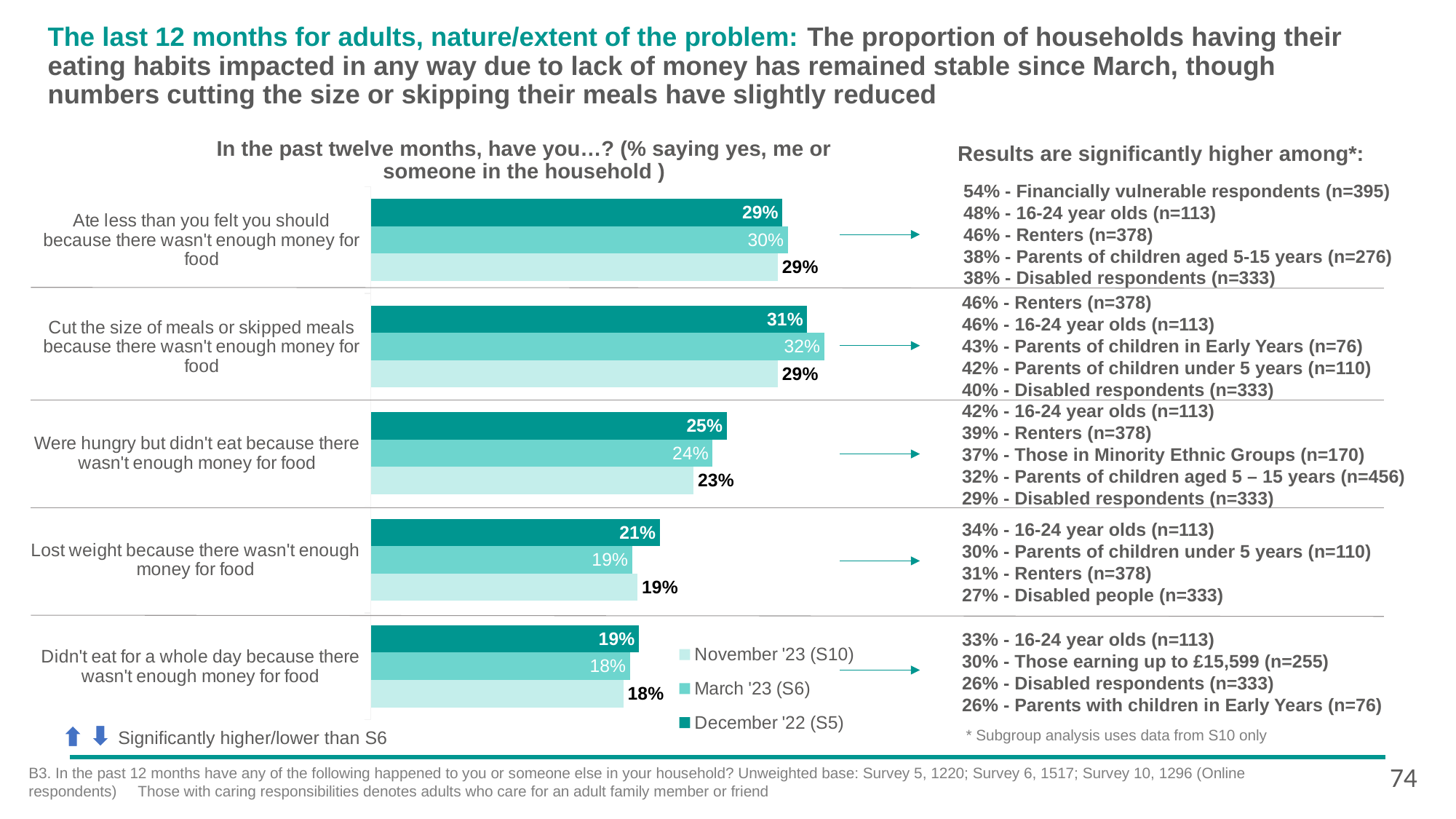
What is the March '23 (S6) value for 'Ate less than you felt you should because there wasn't enough money for food'? 30% What is the November '23 (S10) value for 'Cut the size of meals or skipped meals because there wasn't enough money for food'? 29% What type of chart is shown on the slide? bar chart What is the December '22 (S5) value for 'Were hungry but didn't eat because there wasn't enough money for food'? 25% What is the difference between the March '23 (S6) and November '23 (S10) values for 'Cut the size of meals or skipped meals because there wasn't enough money for food'? 3% Which category has the highest March '23 (S6) value? Cut the size of meals or skipped meals because there wasn't enough money for food How many series does the chart legend list? 3 Which survey wave is shown by the darkest bars in the chart? December '22 (S5) What is the December '22 (S5) value for 'Lost weight because there wasn't enough money for food'? 21% For 'Lost weight because there wasn't enough money for food', which is larger: the December '22 (S5) value or the March '23 (S6) value? December '22 (S5) Which category has the lowest November '23 (S10) value? Didn't eat for a whole day because there wasn't enough money for food How many categories (questions) are plotted in the chart? 5